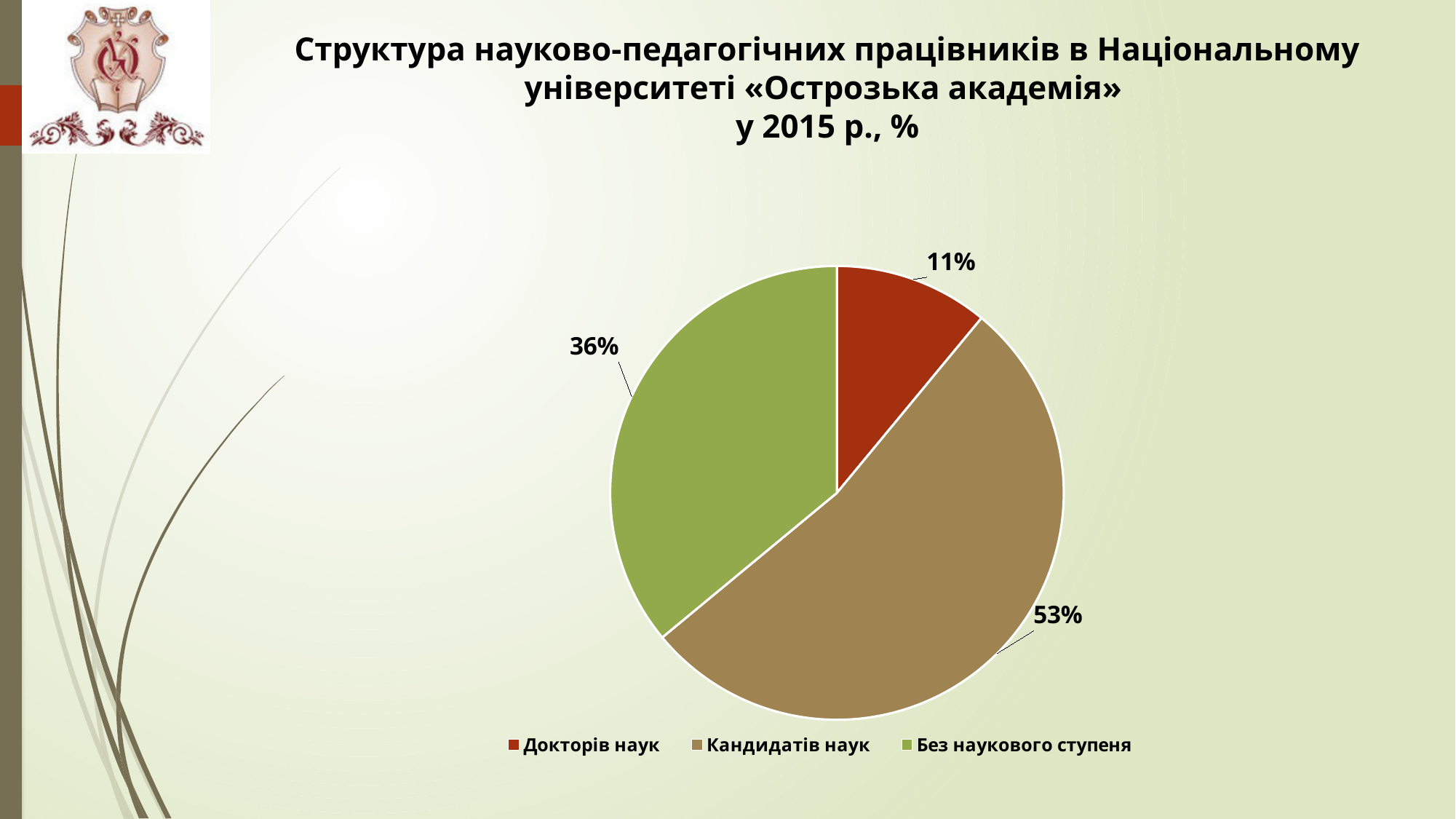
What colour is the slice for Кандидатів наук? brown Which category has the largest slice of the pie? Кандидатів наук Which is larger: the slice for Без наукового ступеня or the slice for Докторів наук? Без наукового ступеня What share of the pie is labelled for Без наукового ступеня? 36% What is the difference in percentage points between Кандидатів наук and Без наукового ступеня? 17 How many slices does the pie chart have? 3 Which category has the smallest slice of the pie? Докторів наук What kind of chart is shown on the slide? pie chart What is the difference in percentage points between Без наукового ступеня and Докторів наук? 25 How many entries does the legend list? 3 What share of the pie is labelled for Докторів наук? 11% What share of the pie is labelled for Кандидатів наук? 53%